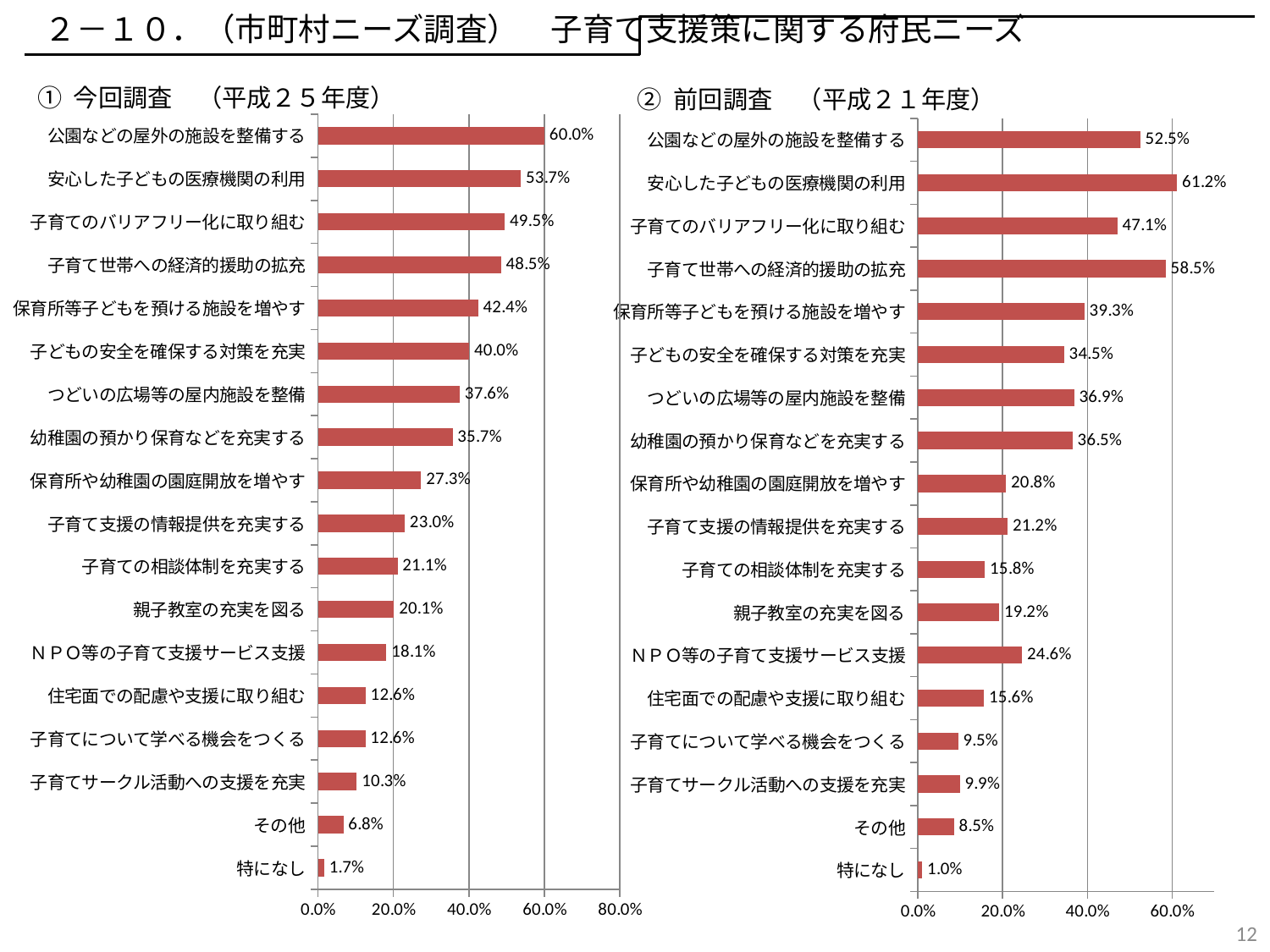
In the ① 今回調査（平成25年度） chart, what is the value for 公園などの屋外の施設を整備する? 60.0% In the ① 今回調査（平成25年度） chart, which category has the lowest value? 特になし In the ② 前回調査（平成21年度） chart, which is larger: 子育て世帯への経済的援助の拡充 or 子育てのバリアフリー化に取り組む? 子育て世帯への経済的援助の拡充 In the ② 前回調査（平成21年度） chart, what is the value for ＮＰＯ等の子育て支援サービス支援? 24.6% In the ② 前回調査（平成21年度） chart, what is the value for 安心した子どもの医療機関の利用? 61.2% In the ① 今回調査（平成25年度） chart, what is the value for 子育てサークル活動への支援を充実? 10.3% In the ② 前回調査（平成21年度） chart, which category has the highest value? 安心した子どもの医療機関の利用 What is the title of the chart on the right side of the slide? ② 前回調査（平成21年度） In the ① 今回調査（平成25年度） chart, is the value for 保育所等子どもを預ける施設を増やす greater or less than 40.0%? greater In the ① 今回調査（平成25年度） chart, what is the difference between 公園などの屋外の施設を整備する and 安心した子どもの医療機関の利用? 6.3% What kind of chart is the ① 今回調査（平成25年度） chart? bar chart How many categories are shown in the ② 前回調査（平成21年度） chart? 18